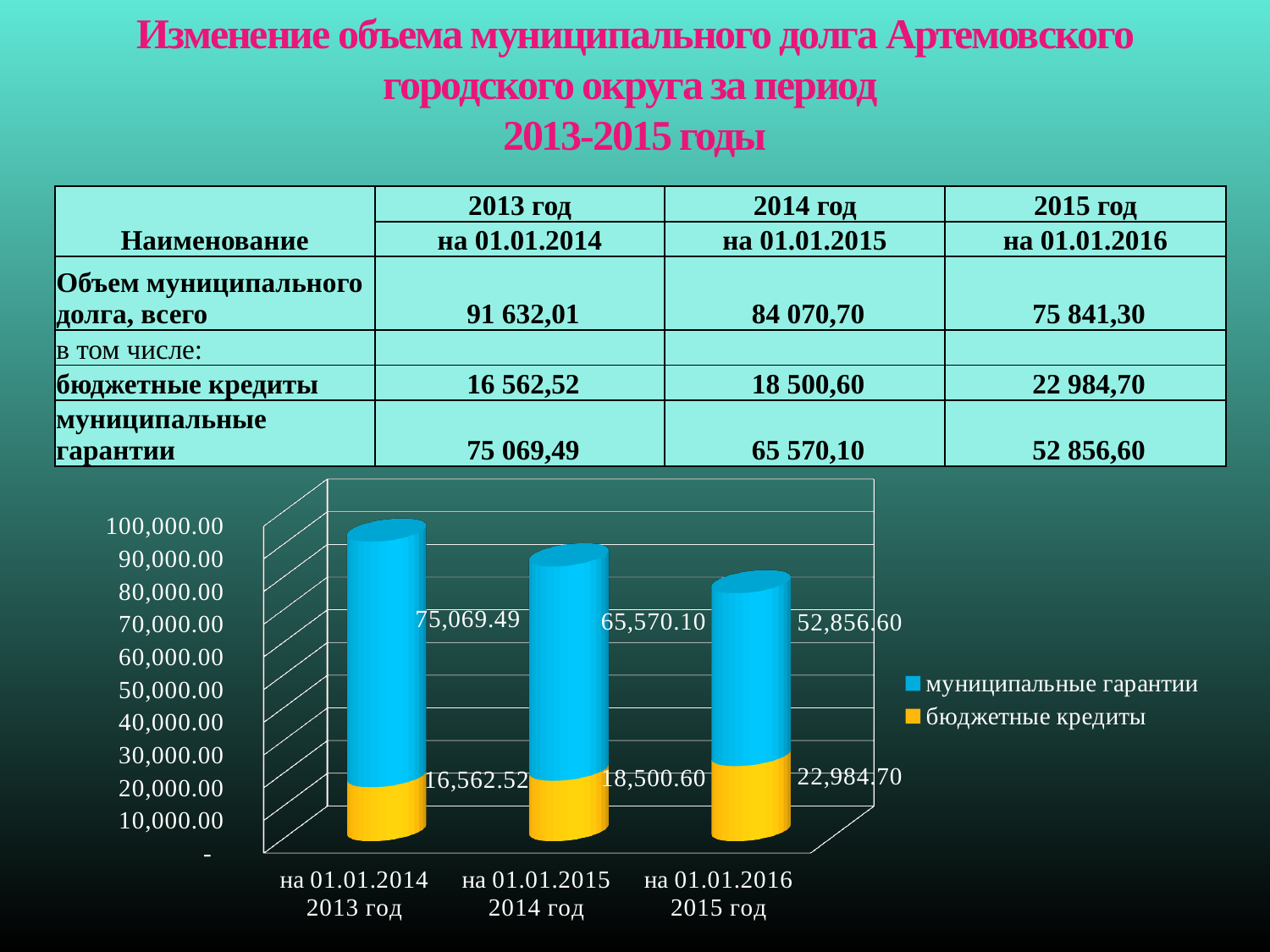
Which category has the lowest value for бюджетные кредиты? на 01.01.2014 2013 год How many categories are shown on the x axis of the chart? 3 What is the difference between бюджетные кредиты for на 01.01.2016 2015 год and на 01.01.2015 2014 год? 4,484.10 What is the value of бюджетные кредиты for на 01.01.2016 2015 год in the chart? 22,984.70 Which is larger: муниципальные гарантии for на 01.01.2015 2014 год or for на 01.01.2016 2015 год? на 01.01.2015 2014 год Which category has the highest value for муниципальные гарантии? на 01.01.2014 2013 год Do the values for муниципальные гарантии rise or fall across the categories from left to right? fall How many series does the chart legend list? 2 What kind of chart is shown on the slide? stacked bar chart What is the total of the stacked bar for на 01.01.2014 2013 год? 91,632.01 What is the value of муниципальные гарантии for на 01.01.2015 2014 год in the chart? 65,570.10 What is the value of муниципальные гарантии for на 01.01.2014 2013 год in the chart? 75,069.49